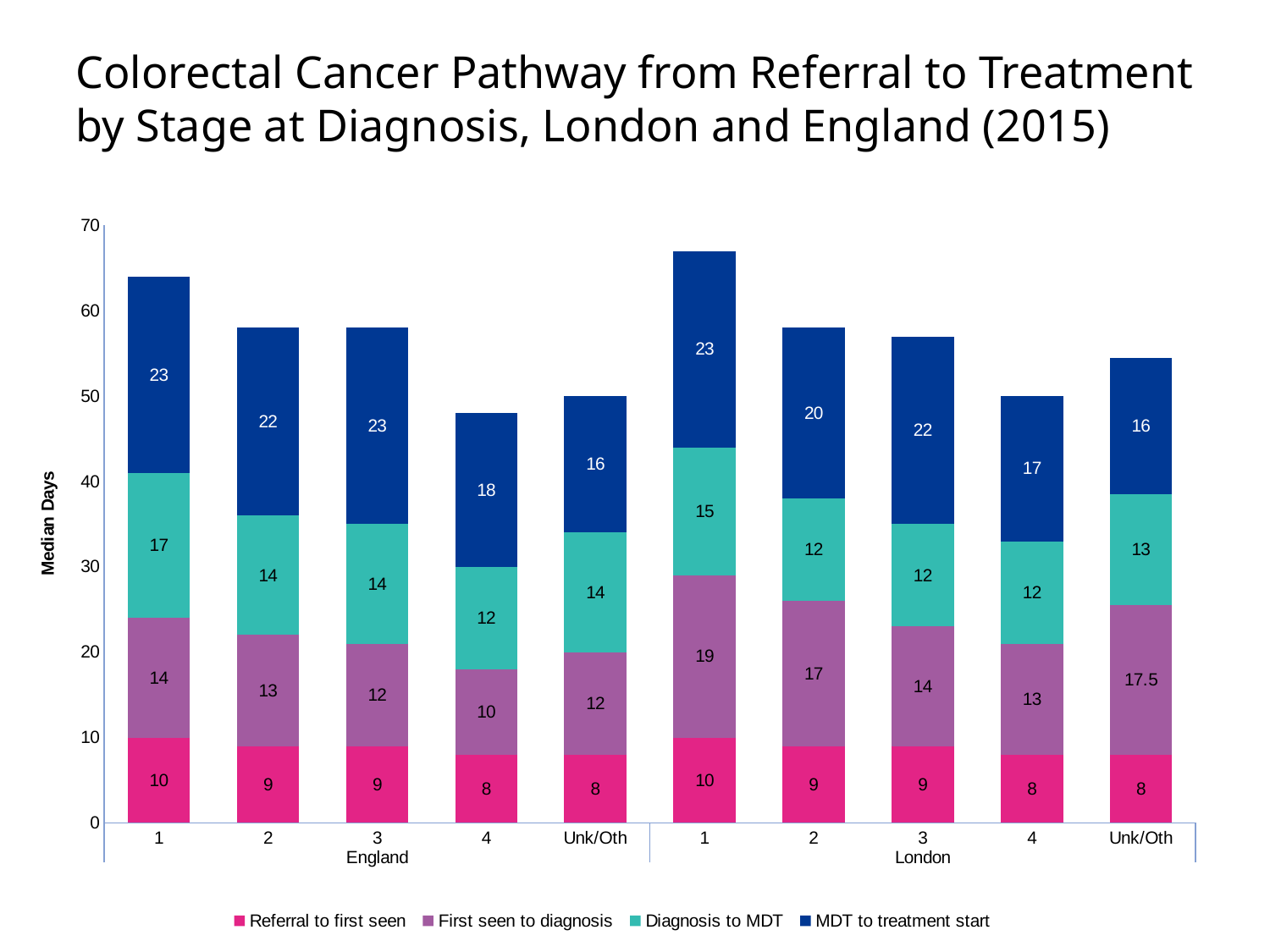
Which stage in London has the tallest stacked bar? 1 Which is larger: 'MDT to treatment start' for stage 2 in England or for stage 2 in London? England What is the difference in 'Diagnosis to MDT' median days between stage 1 in England and stage 1 in London? 2 How many stacked bars are plotted in total on the chart? 10 What is the total median days for the stage 1 bar in England? 64 What kind of chart is shown on the slide? Stacked bar chart What is the median number of days for 'First seen to diagnosis' for stage 1 in London? 19 What is the median number of days for 'MDT to treatment start' for stage 4 in England? 18 What is the total median days for the stage 1 bar in London? 67 What is the label on the vertical axis? Median Days What is the median number of days for 'First seen to diagnosis' for Unk/Oth in London? 17.5 How many series does the legend list? 4